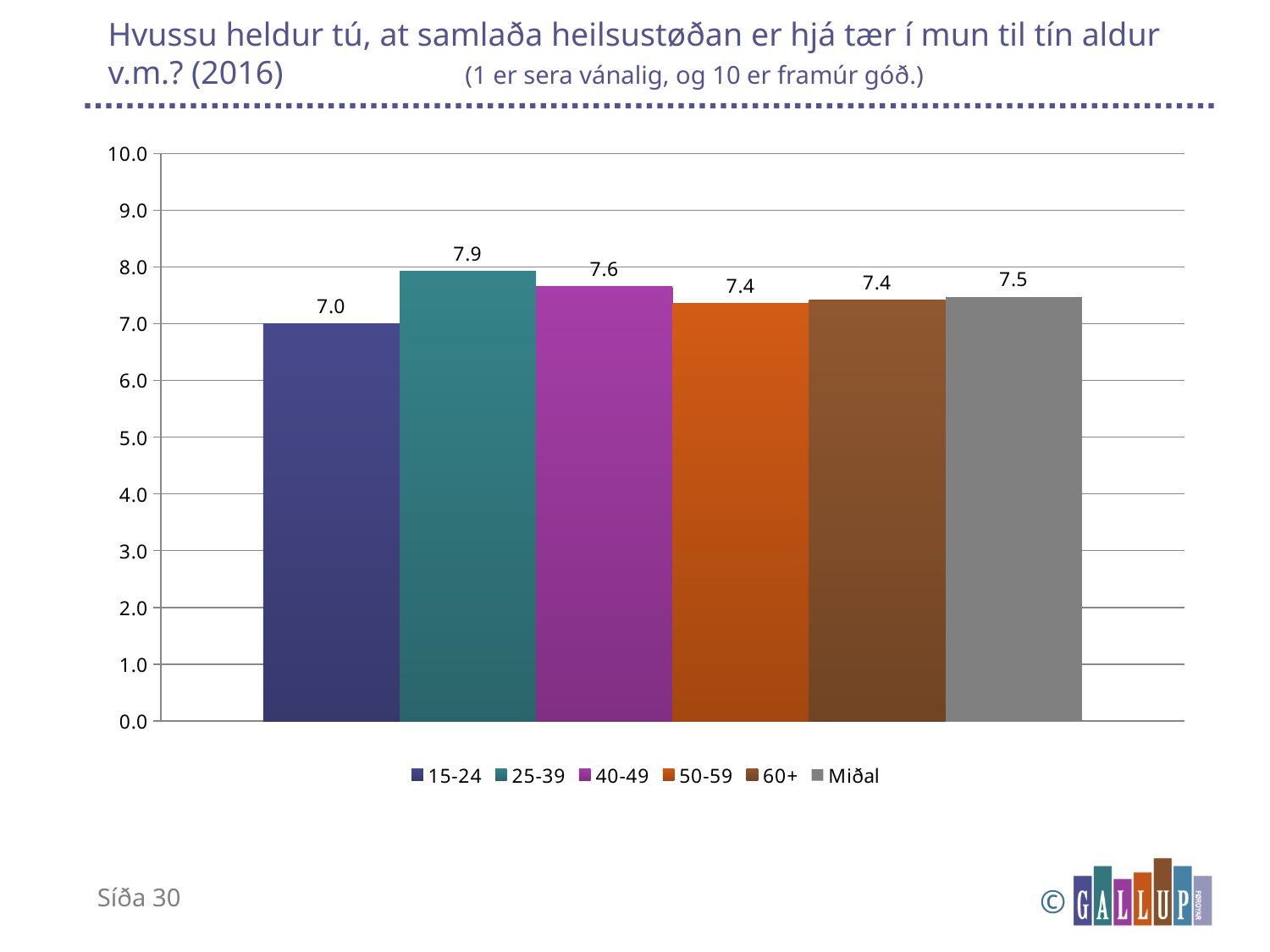
What is the value for Miðal? 7.5 What kind of chart is shown on the slide? bar chart Which age group has the highest value? 25-39 What is the difference between the values for 25-39 and 15-24? 0.9 What is the value for the 25-39 age group? 7.9 What is the value for the 15-24 age group? 7.0 Which age group has the lowest value? 15-24 Which is larger, the value for 40-49 or the value for 50-59? 40-49 Is the value for 60+ greater or less than 8.0? less How many bars are shown in the chart? 6 How many entries does the legend list? 6 What is the maximum value shown on the vertical axis? 10.0